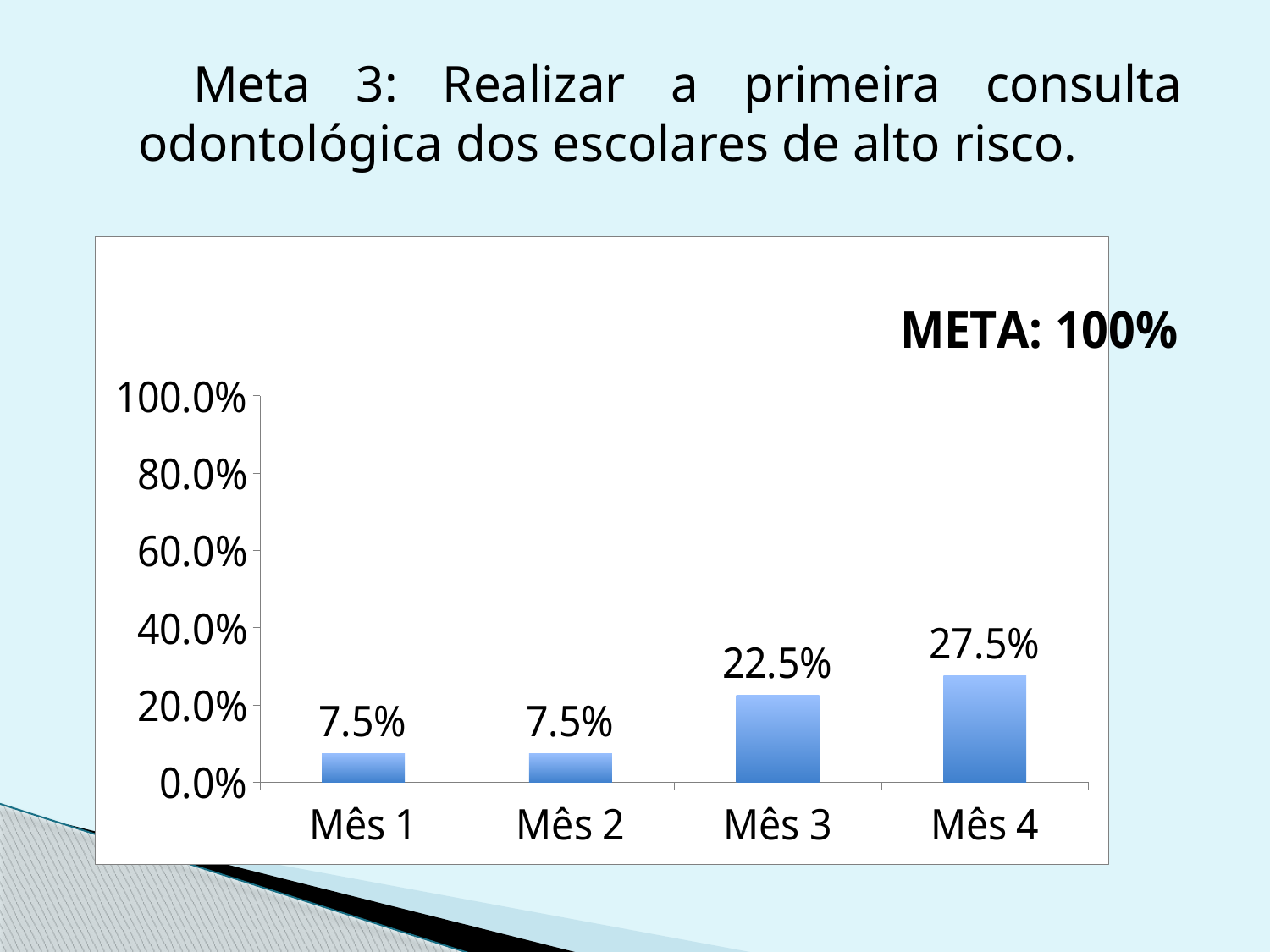
What is the value for Mês 4? 27.5% Is the value for Mês 4 greater or less than 40.0%? less What is the difference between the values for Mês 3 and Mês 2? 15.0% How many months are shown on the x axis? 4 Do the values rise or fall from Mês 1 to Mês 4? rise Which month has the highest value? Mês 4 What target (META) is stated on the chart? 100% What is the difference between the values for Mês 4 and Mês 3? 5.0% What is the value for Mês 1? 7.5% What is the value for Mês 3? 22.5% Which is larger, the value for Mês 3 or the value for Mês 1? Mês 3 What kind of chart is shown on the slide? bar chart